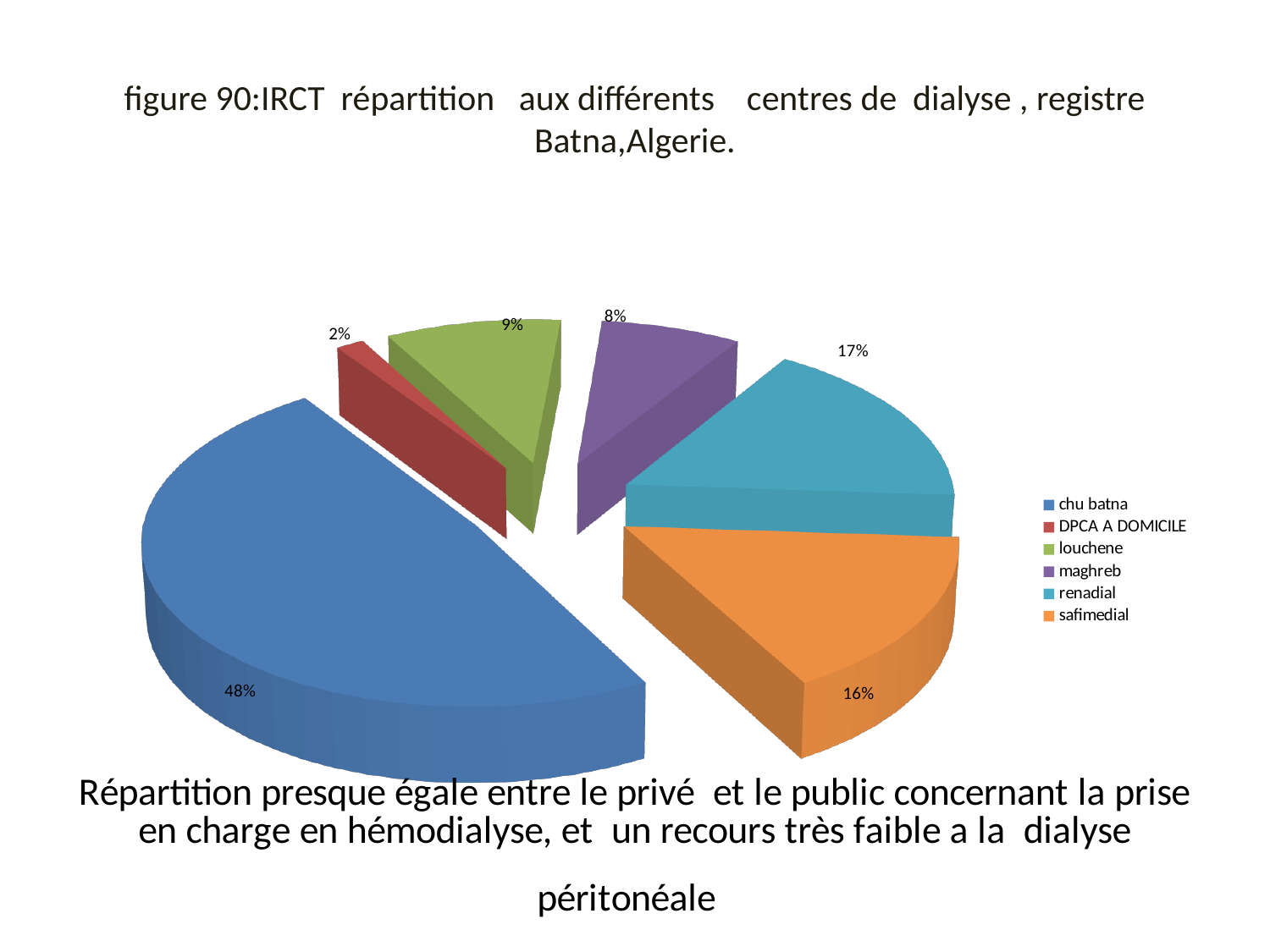
What share of the pie does DPCA A DOMICILE have? 2% What share of the pie does louchene have? 9% How many categories does the pie chart have? 6 Which category has the smallest slice of the pie? DPCA A DOMICILE What share of the pie does chu batna have? 48% What is the difference between the shares of chu batna and renadial? 31% Which category has the largest slice of the pie? chu batna What kind of chart is shown on the slide? pie chart Which colour represents safimedial in the legend? orange